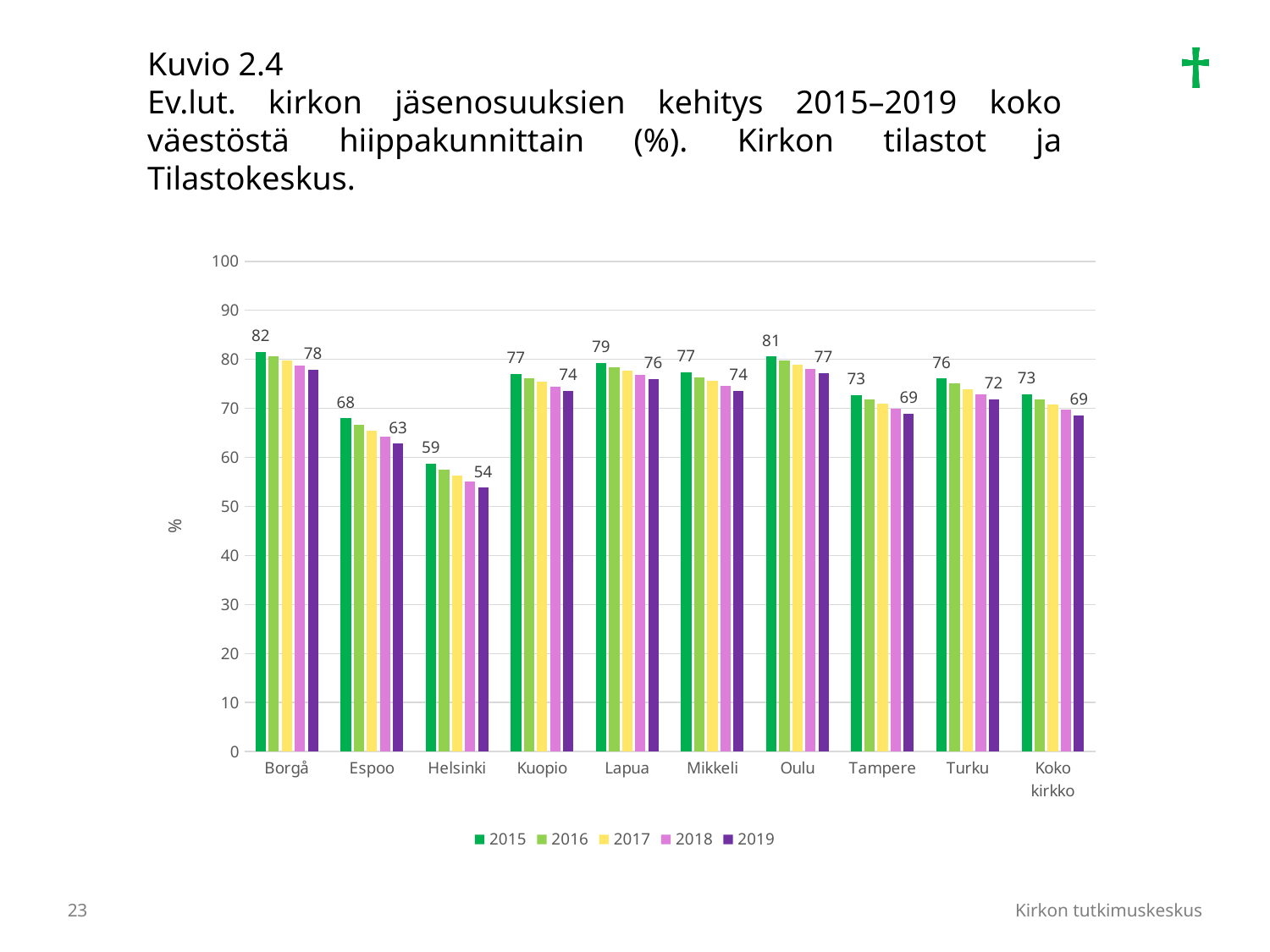
Which diocese has the lowest value in 2019? Helsinki What is the difference between the 2015 and 2019 values for Espoo? 5 Which is larger, the 2019 value for Lapua or the 2019 value for Tampere? Lapua What is the value for Borgå in 2015? 82 Do the values for Borgå rise or fall from 2015 to 2019? fall Which diocese has the highest value in 2015? Borgå How many series does the legend list? 5 How many dioceses (categories) are shown on the x axis? 10 What is the value for Koko kirkko in 2019? 69 What is the value for Oulu in 2015? 81 Is the value for Espoo in 2017 greater or less than 70? less What is the value for Helsinki in 2019? 54